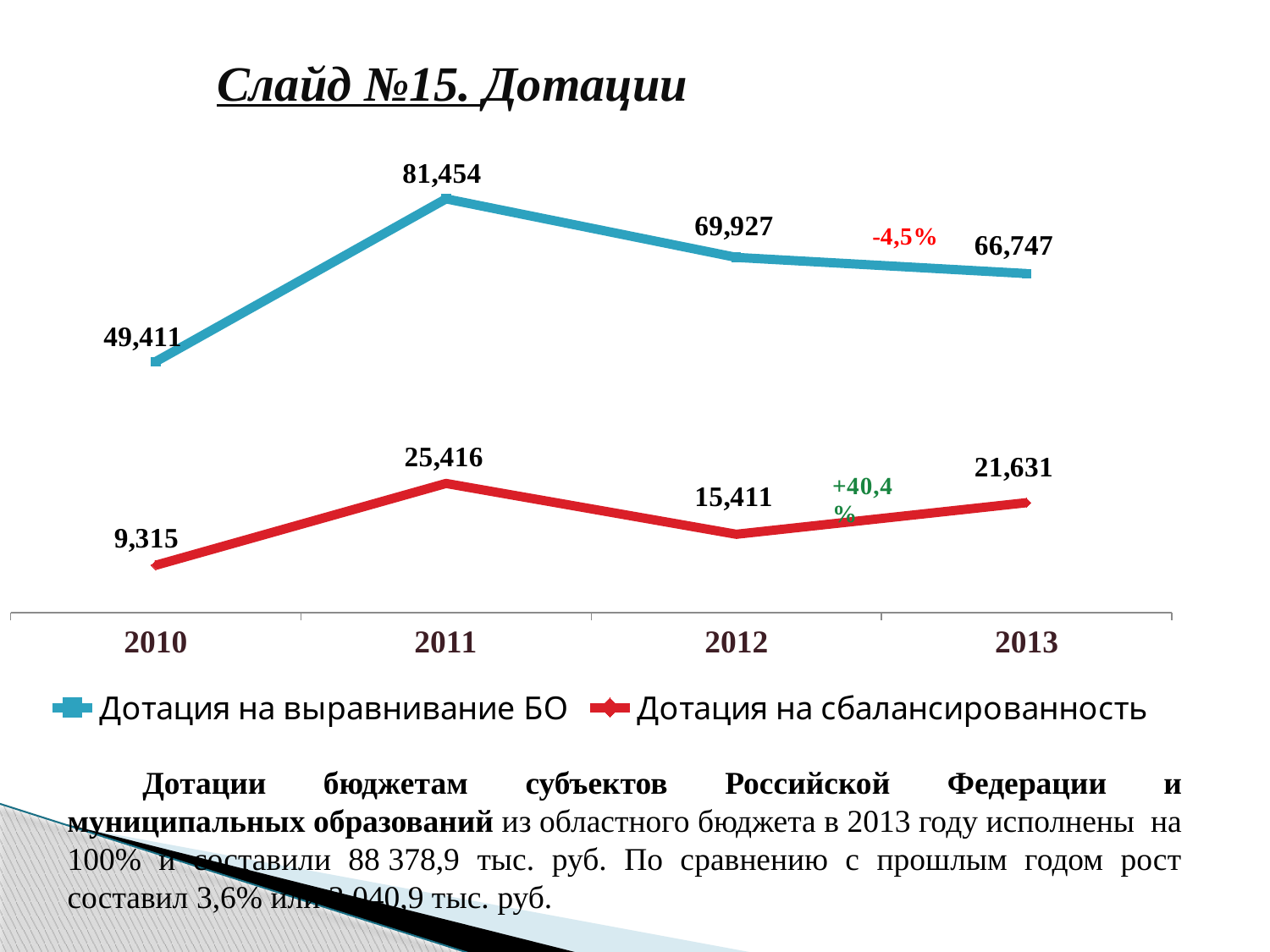
What is the value of "Дотация на выравнивание БО" in 2011? 81,454 What is the value of "Дотация на сбалансированность" in 2013? 21,631 What percentage change is annotated next to the "Дотация на выравнивание БО" line between 2012 and 2013? -4,5% What type of chart is shown on the slide? line chart Which series has the larger value in 2012, "Дотация на выравнивание БО" or "Дотация на сбалансированность"? Дотация на выравнивание БО How many years are shown on the x axis? 4 What is the difference between the 2013 and 2012 values of "Дотация на сбалансированность"? 6,220 What is the difference between the 2011 and 2010 values of "Дотация на выравнивание БО"? 32,043 In which year is "Дотация на сбалансированность" lowest? 2010 What is the value of "Дотация на выравнивание БО" in 2010? 49,411 How many series does the legend list? 2 In which year is "Дотация на выравнивание БО" highest? 2011